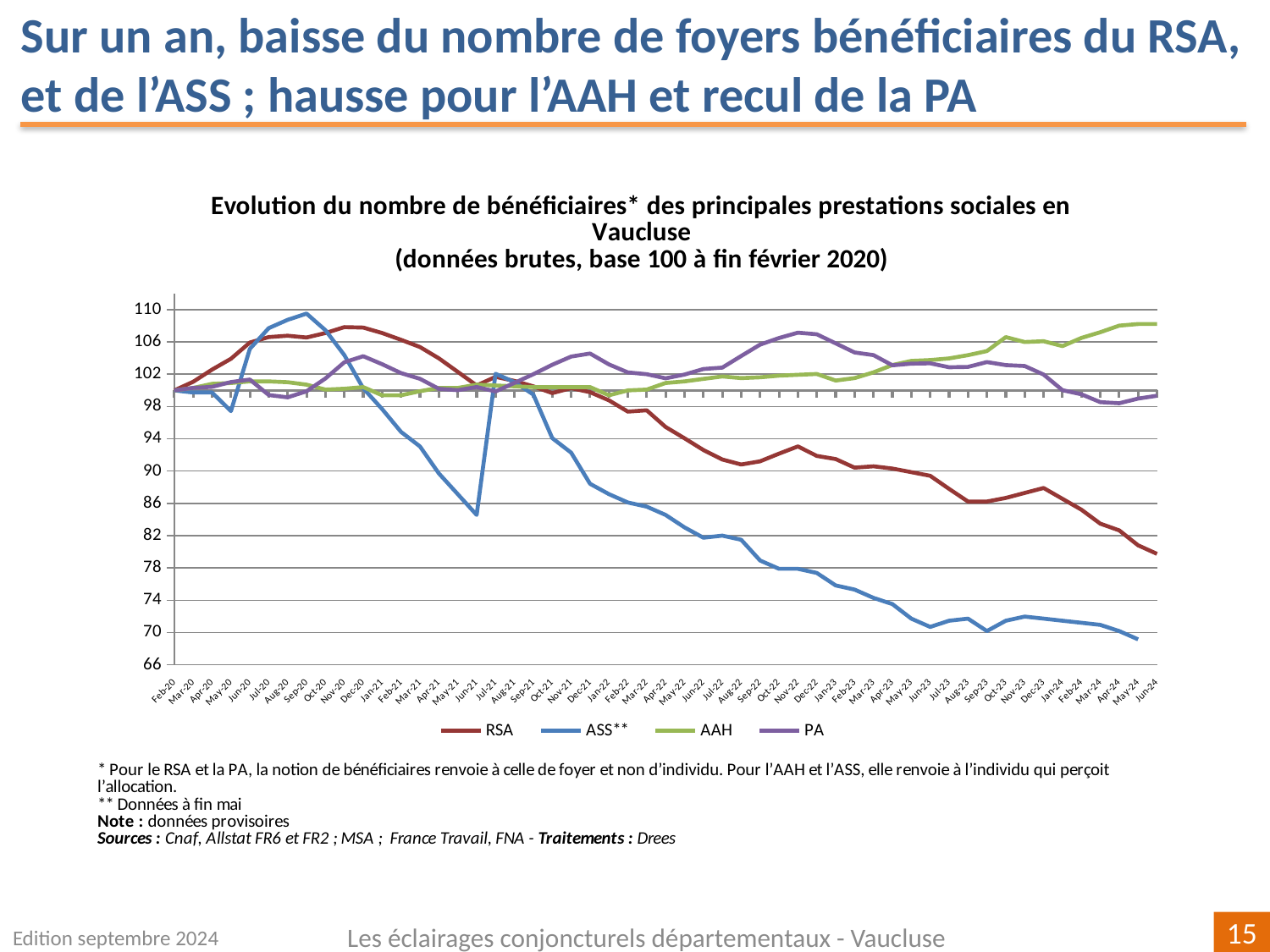
What kind of chart is shown on the slide? line chart According to the chart title, which month is the base 100 reference? fin février 2020 Which series has the highest value at Jun-24? AAH Does the ASS** series rise or fall overall from Sep-20 to Jun-24? fall Is the value for ASS** at Sep-20 greater or less than 106? greater Is the value for AAH at Jun-24 greater or less than 106? greater Is the value for RSA at Jun-24 greater or less than 82? less How many series does the legend list? 4 Which series has the lowest value at Jun-24? RSA Does the AAH series rise or fall overall from Feb-20 to Jun-24? rise